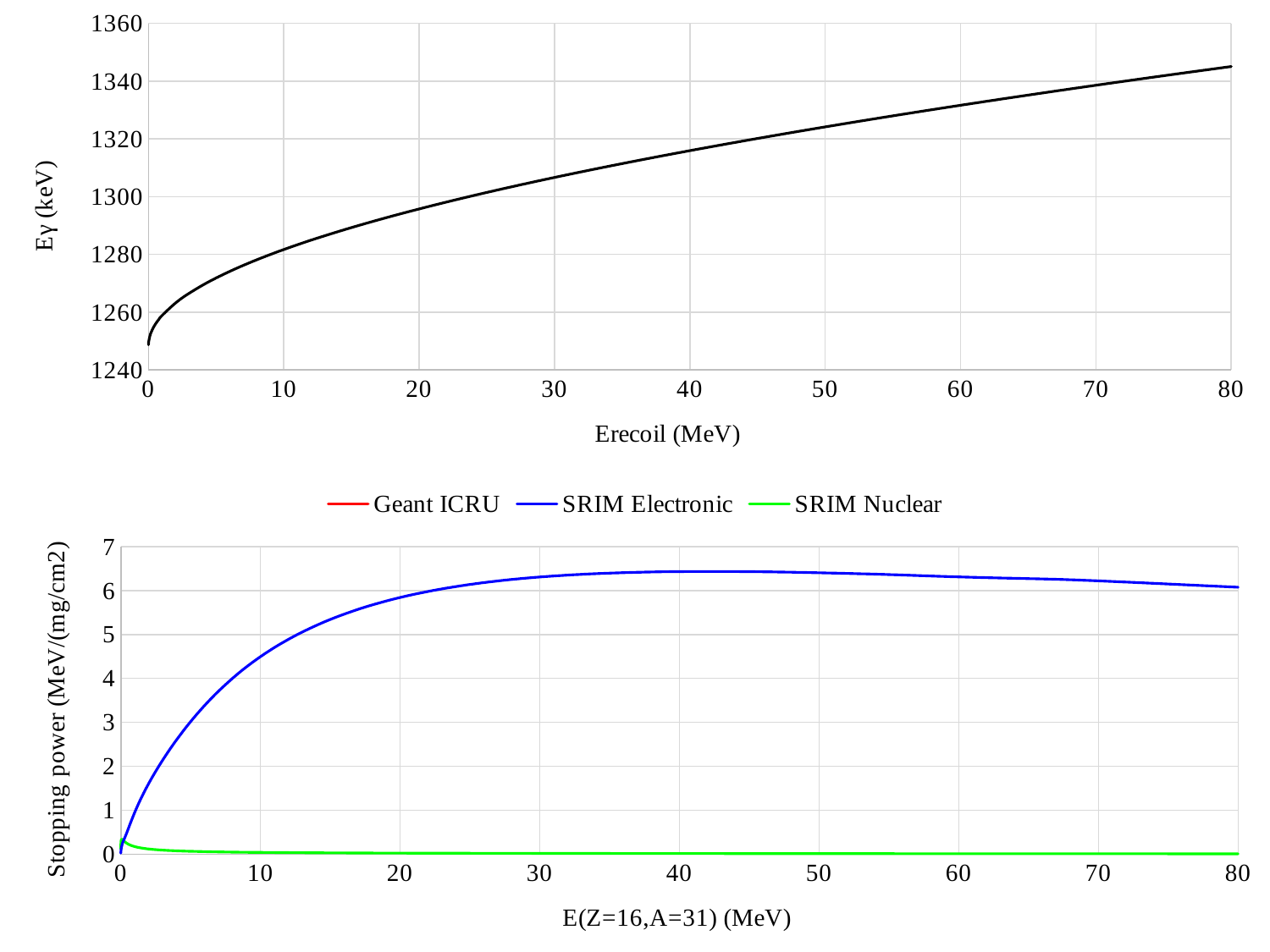
In the bottom chart, is the SRIM Electronic stopping power at 40 MeV greater or less than 6? greater In the bottom chart, is the SRIM Nuclear stopping power at 40 MeV greater or less than 1? less In the top chart, does Eγ rise or fall as Erecoil increases from 0 to 80 MeV? rise How many series does the legend of the bottom chart list? 3 In the top chart, is the value of Eγ at Erecoil = 80 MeV greater or less than 1340? greater What kind of chart is the top chart on the slide? line chart What kind of chart is the bottom chart on the slide? line chart In the bottom chart's legend, what colour is used for SRIM Nuclear? green In the bottom chart, which series has the larger value at 40 MeV, SRIM Electronic or SRIM Nuclear? SRIM Electronic In the bottom chart, does the SRIM Nuclear series rise or fall as energy increases from 0 to 80 MeV? fall